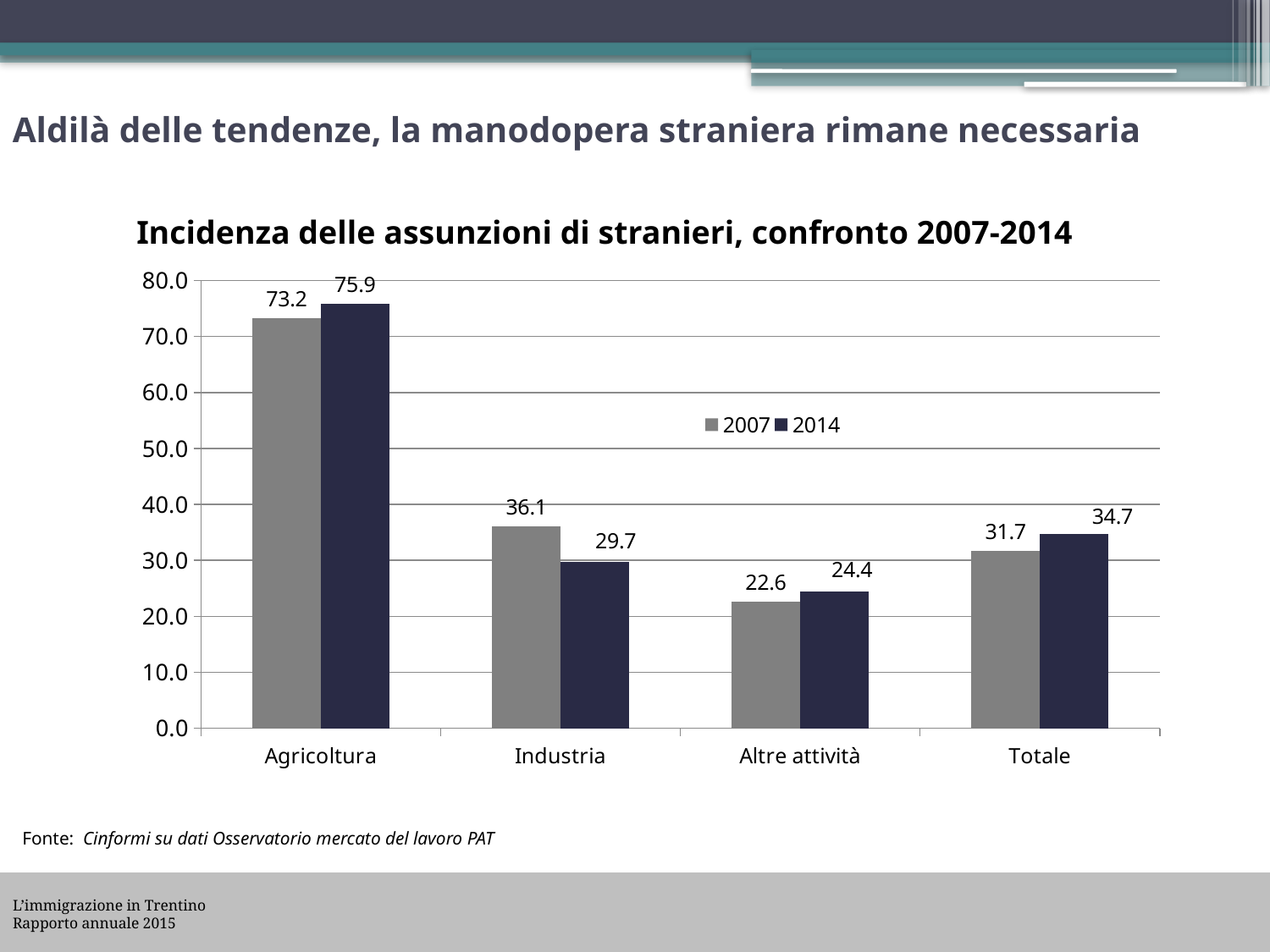
What is the difference between the 2007 and 2014 values for Industria? 6.4 Which is larger for Totale, the 2007 value or the 2014 value? 2014 What is the value for Totale in 2007? 31.7 What is the value for Industria in 2007? 36.1 What is the value for Altre attività in 2014? 24.4 Which category has the highest value in 2014? Agricoltura Which category has the lowest value in 2007? Altre attività Is the value for Agricoltura in 2007 greater or less than 70.0? greater What kind of chart is shown on the slide? Bar chart What is the value for Agricoltura in 2014? 75.9 How many categories are shown on the x axis? 4 How many series does the legend list? 2